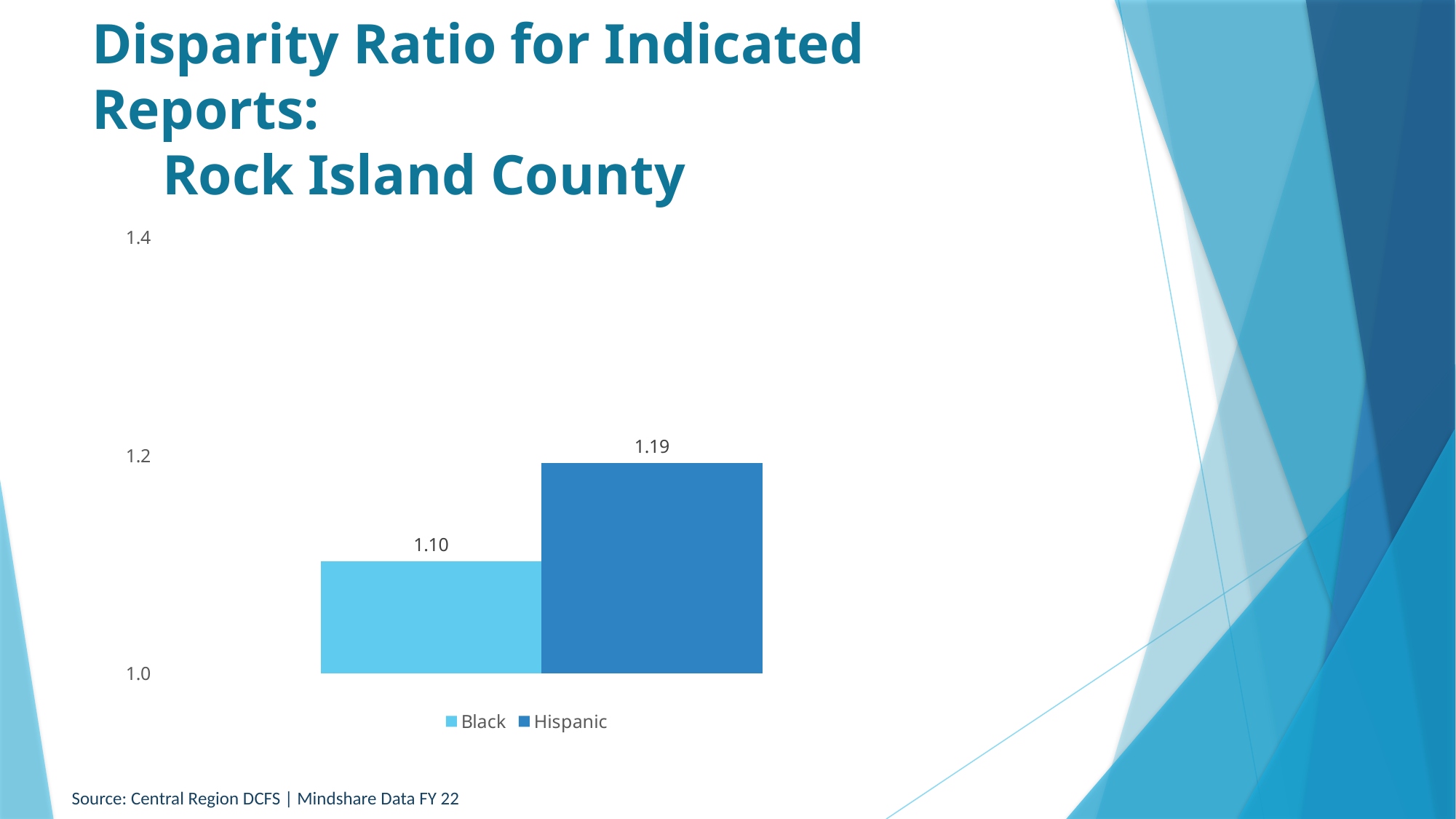
Which group has the lower disparity ratio? Black Is the disparity ratio for Black larger or smaller than the ratio for Hispanic? smaller What kind of chart is shown on the slide? bar chart How many series does the legend list? 2 Which group has the higher disparity ratio? Hispanic Is the value for Black greater or less than 1.0? greater Is the value for Hispanic greater or less than 1.2? less How many bars are plotted in the chart? 2 What is the disparity ratio for Hispanic? 1.19 What is the disparity ratio for Black? 1.10 What is the highest value shown on the vertical axis? 1.4 What is the difference between the Hispanic and Black disparity ratios? 0.09